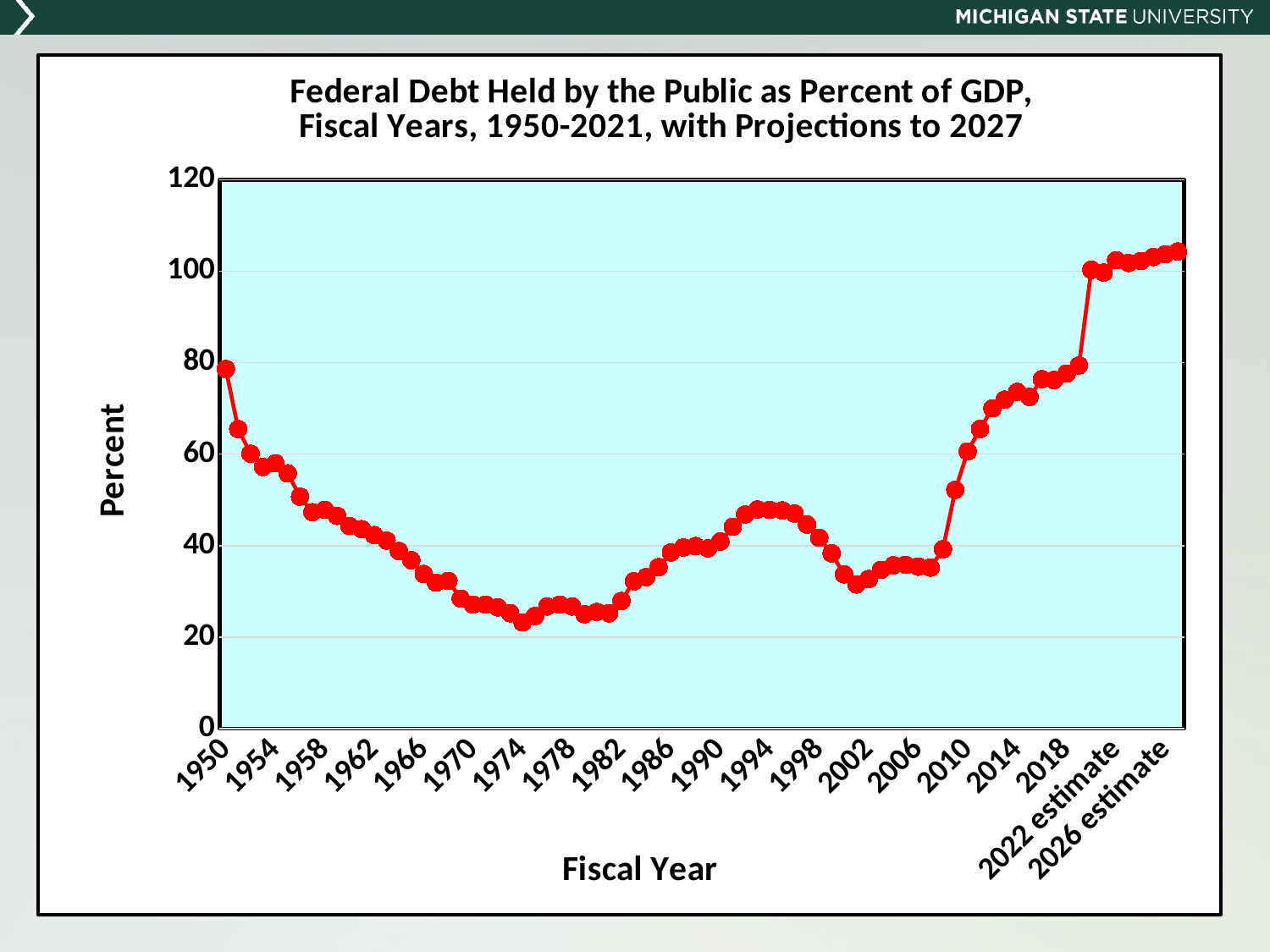
Which is larger, the value for 1994 or the value for the 2026 estimate? 2026 estimate What is the label on the vertical axis of the chart? Percent Do the values rise or fall from 2008 to the 2026 estimate? rise Which is larger, the value for 1950 or the value for 1974? 1950 Is the value for 1998 greater or less than 60? less What kind of chart is shown on the slide? line chart Is the value for 1974 greater or less than 40? less Is the value for 2010 greater or less than 80? less Do the values rise or fall from 1950 to 1974? fall What is the title of the chart? Federal Debt Held by the Public as Percent of GDP, Fiscal Years, 1950-2021, with Projections to 2027